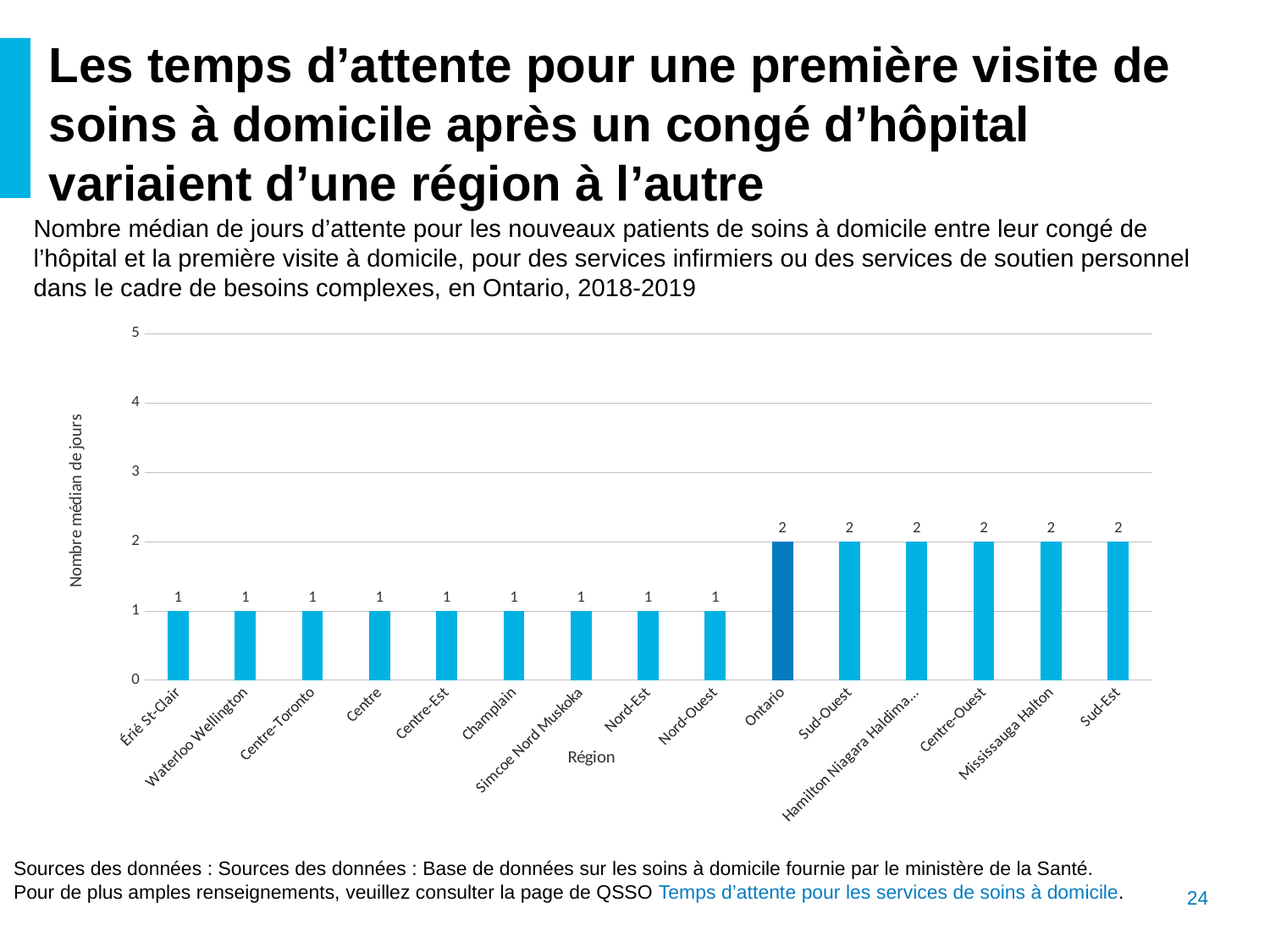
How many regions have a value of 2? 6 Which bar is shown in a darker blue than the others? Ontario What is the difference between the values for Sud-Est and Érié St-Clair? 1 Which has a larger value, Waterloo Wellington or Sud-Ouest? Sud-Ouest What is the median number of days for Ontario? 2 What is the median number of days for Nord-Ouest? 1 How many regions are shown on the x axis of the chart? 15 Which has a larger value, Centre-Ouest or Centre-Est? Centre-Ouest What is the median number of days for Champlain? 1 What is the label of the y axis? Nombre médian de jours What is the median number of days for Mississauga Halton? 2 What kind of chart is shown on the slide? Bar chart